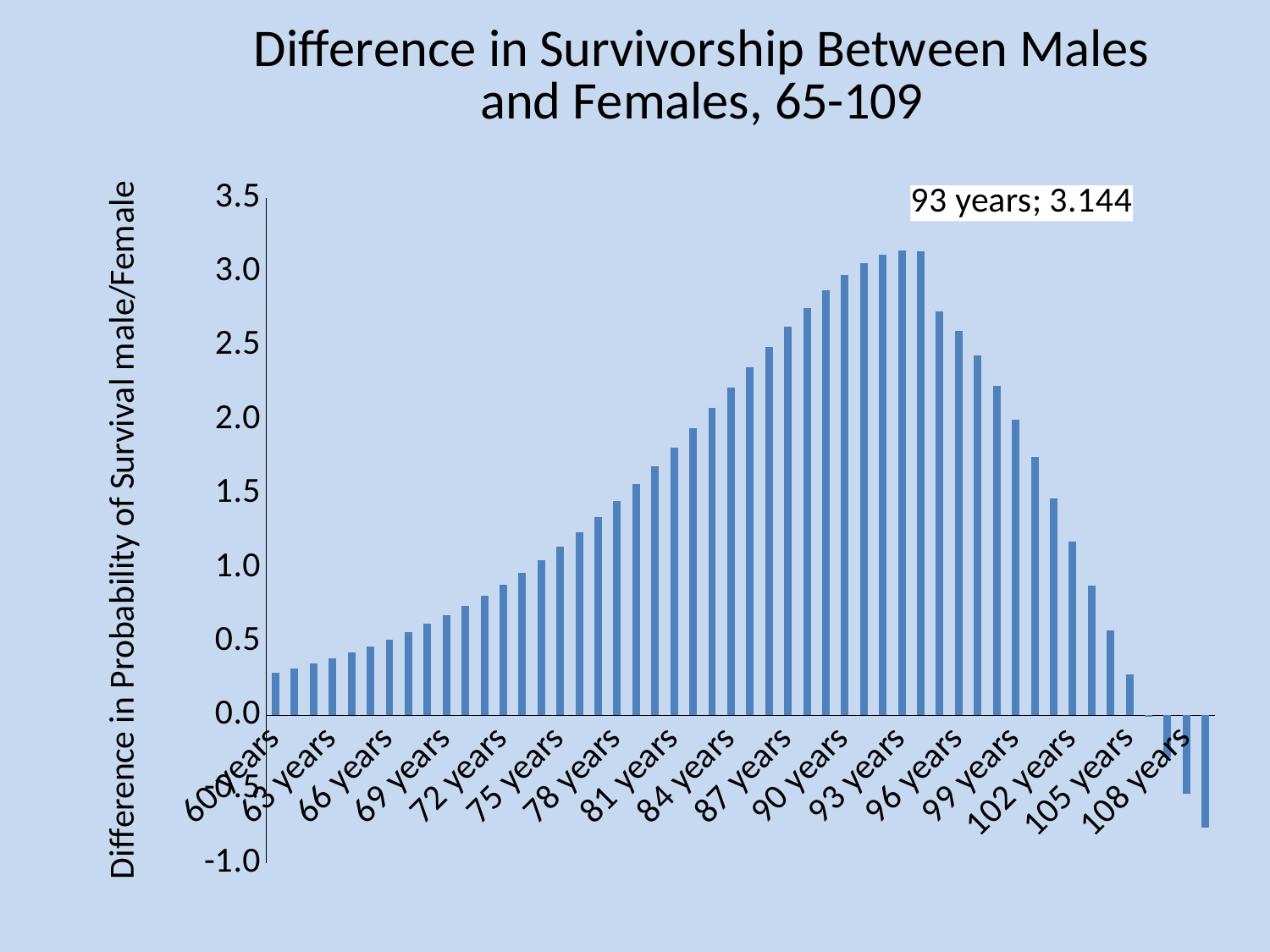
Is the value for 60 years greater or less than 0.5? less Which age has the highest difference in survivorship? 93 years What value is printed on the data label for 93 years? 3.144 Do the values rise or fall from 60 years to 93 years? rise Is the value for 90 years greater or less than 2.5? greater Which has the larger value, 66 years or 99 years? 99 years What is the title of the vertical axis? Difference in Probability of Survival male/Female Do the values rise or fall from 93 years to 108 years? fall Which has the larger value, 75 years or 90 years? 90 years Is the value for 108 years greater or less than 0.0? less What kind of chart is shown on the slide? bar chart